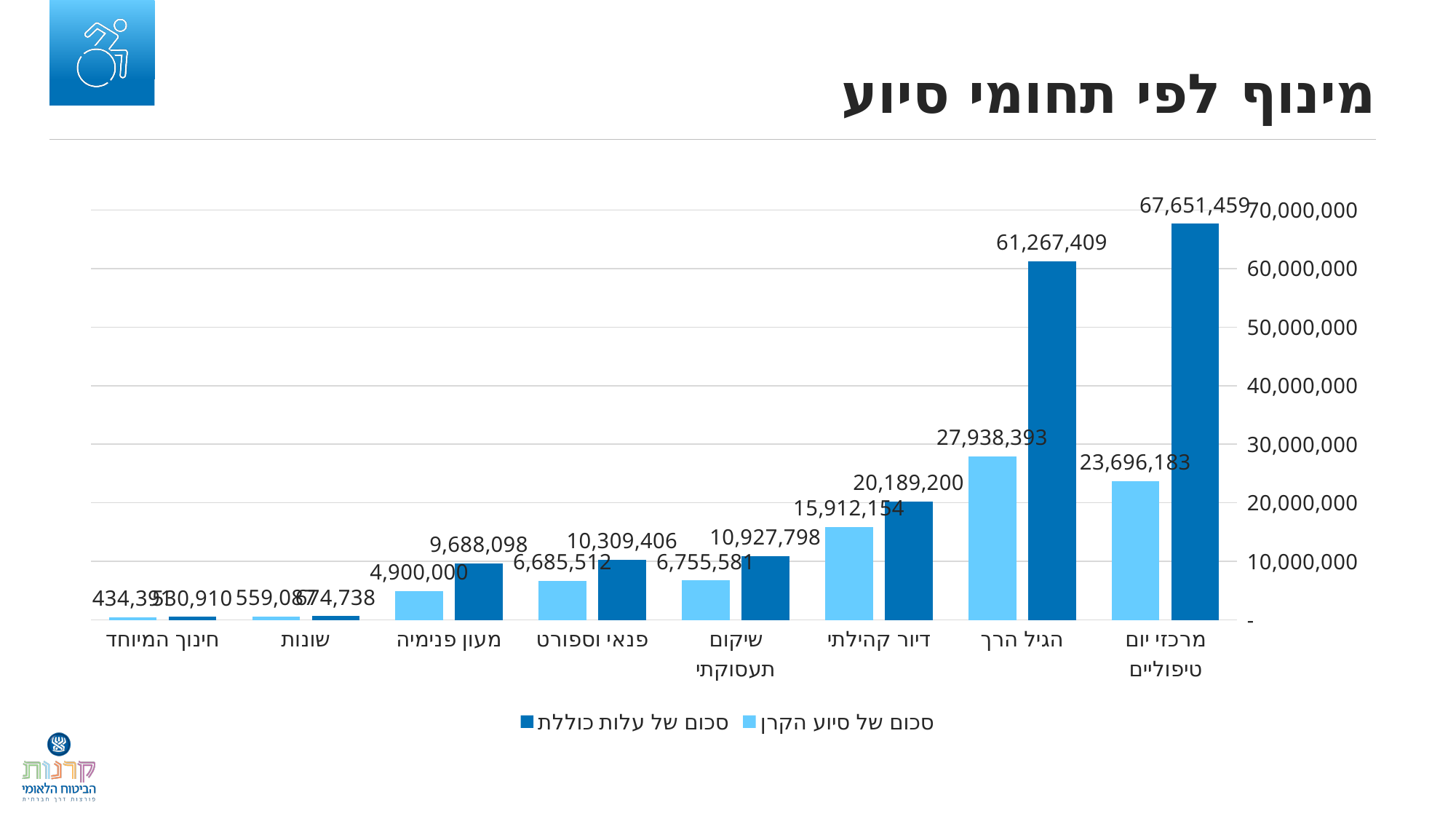
What is the value of סכום של עלות כוללת for מרכזי יום טיפוליים? 67,651,459 Which is larger: סכום של סיוע הקרן for הגיל הרך or for מרכזי יום טיפוליים? הגיל הרך What is the value of סכום של סיוע הקרן for הגיל הרך? 27,938,393 What is the difference between סכום של עלות כוללת and סכום של סיוע הקרן for מרכזי יום טיפוליים? 43,955,276 What is the value of סכום של סיוע הקרן for מעון פנימיה? 4,900,000 What type of chart is shown on the slide? bar chart What is the value of סכום של עלות כוללת for דיור קהילתי? 20,189,200 Which category has the highest value for סכום של סיוע הקרן? הגיל הרך Is the value of סכום של עלות כוללת for הגיל הרך greater or less than 60,000,000? greater How many series does the legend list? 2 How many categories are shown on the x axis? 8 Which category has the highest value for סכום של עלות כוללת? מרכזי יום טיפוליים